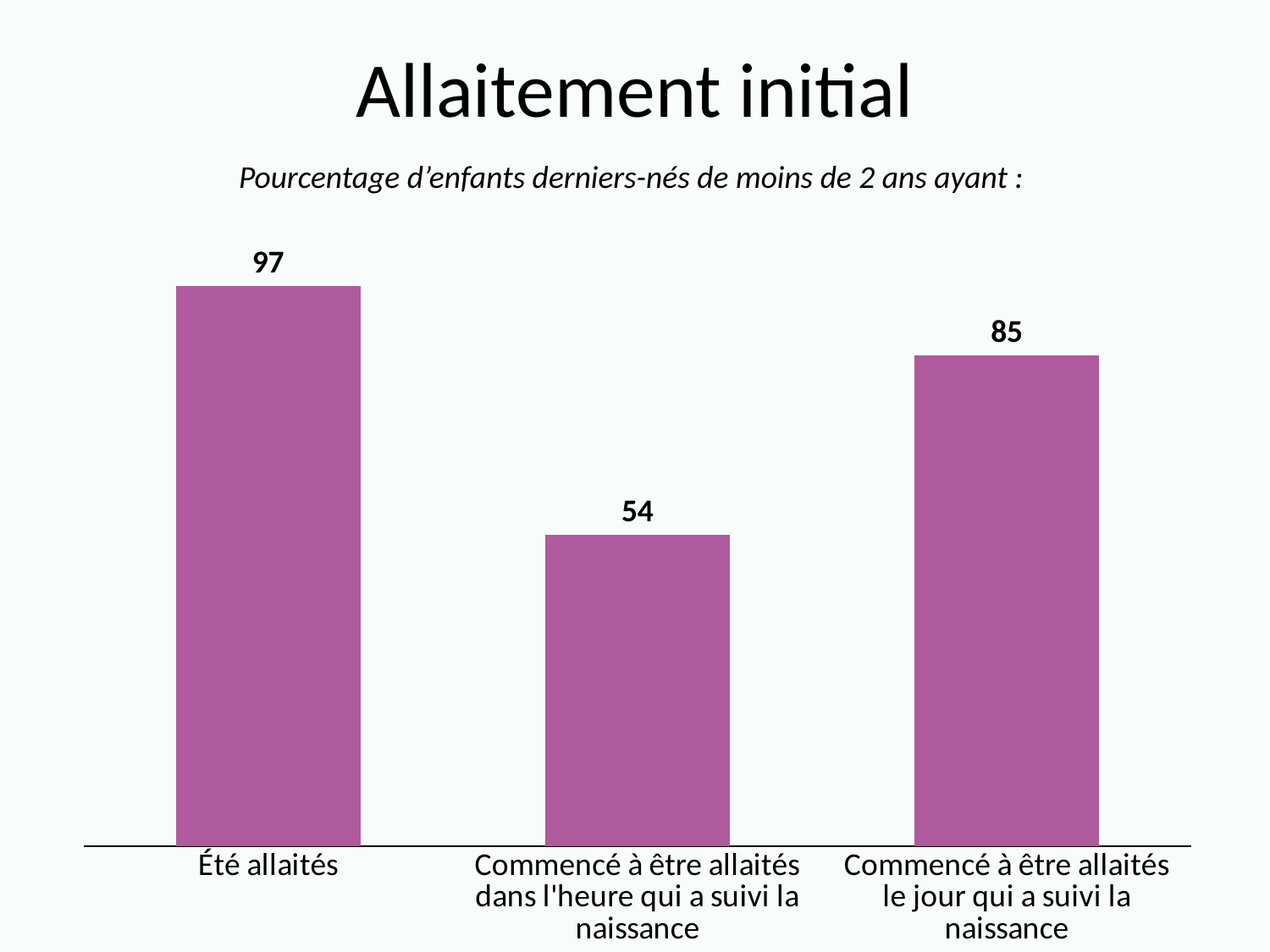
What is the value for "Commencé à être allaités le jour qui a suivi la naissance"? 85 What is the value for "Commencé à être allaités dans l'heure qui a suivi la naissance"? 54 What colour are the bars in the chart? Purple How many categories are shown in the chart? 3 What kind of chart is shown on the slide? Bar chart Which category has the highest value? Été allaités What is the difference between the value for "Commencé à être allaités le jour qui a suivi la naissance" and the value for "Commencé à être allaités dans l'heure qui a suivi la naissance"? 31 What is the difference between the value for "Été allaités" and the value for "Commencé à être allaités le jour qui a suivi la naissance"? 12 What is the value for "Été allaités"? 97 What is the title of the slide? Allaitement initial Which is larger: the value for "Commencé à être allaités dans l'heure qui a suivi la naissance" or the value for "Commencé à être allaités le jour qui a suivi la naissance"? Commencé à être allaités le jour qui a suivi la naissance Which category has the lowest value? Commencé à être allaités dans l'heure qui a suivi la naissance